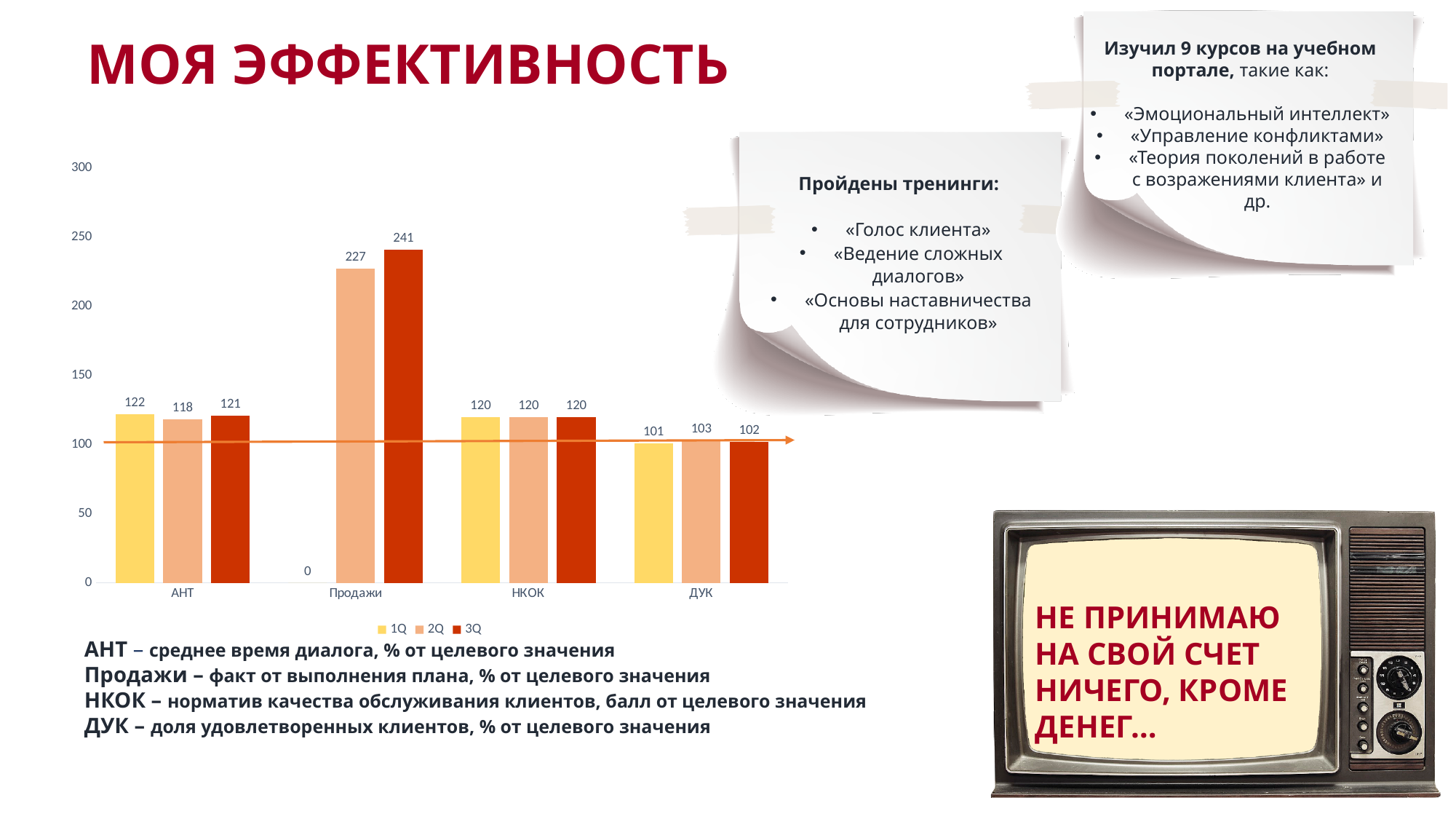
Which is larger: the 1Q value for АНТ or the 1Q value for НКОК? АНТ What are the series names listed in the legend? 1Q, 2Q, 3Q How many categories are shown on the x axis? 4 What is the 1Q value for Продажи? 0 What is the 3Q value for Продажи? 241 What type of chart is shown on the slide? bar chart Which category has the lowest 2Q value? ДУК What is the 1Q value for АНТ? 122 What is the 2Q value for ДУК? 103 What is the difference between the 3Q and 2Q values for Продажи? 14 How many series does the legend list? 3 Which category has the highest 3Q value? Продажи